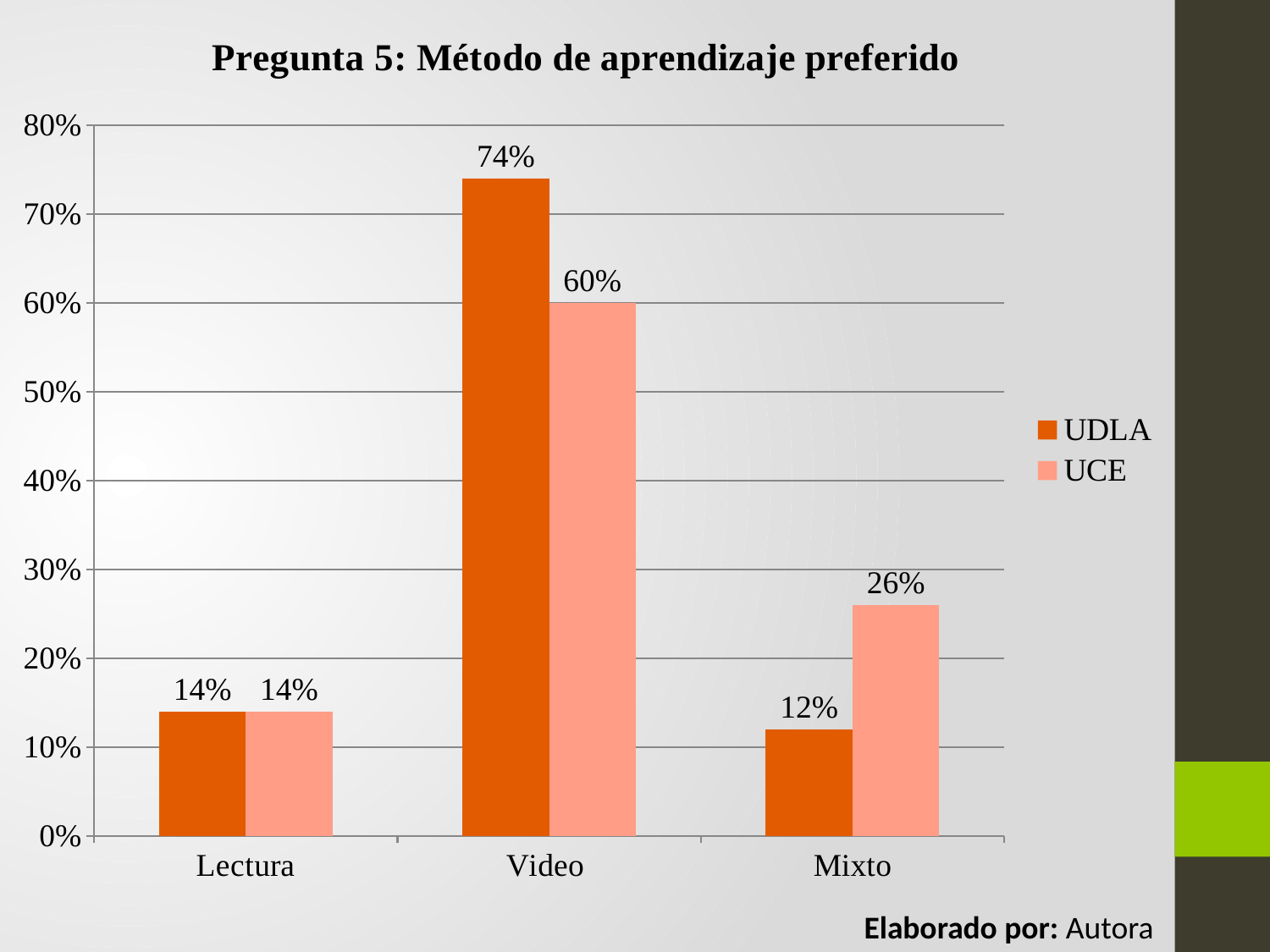
What is the UCE value for Video? 60% What is the UDLA value for Lectura? 14% How many series does the legend list? 2 What is the title of the chart? Pregunta 5: Método de aprendizaje preferido What kind of chart is shown on the slide? Bar chart What is the difference between the UDLA and UCE values for Video? 14% What is the UDLA value for Video? 74% What is the UCE value for Mixto? 26% How many categories are shown on the x axis? 3 Which category has the lowest UDLA value? Mixto Which category has the highest UDLA value? Video Which is larger for Mixto, the UDLA value or the UCE value? UCE